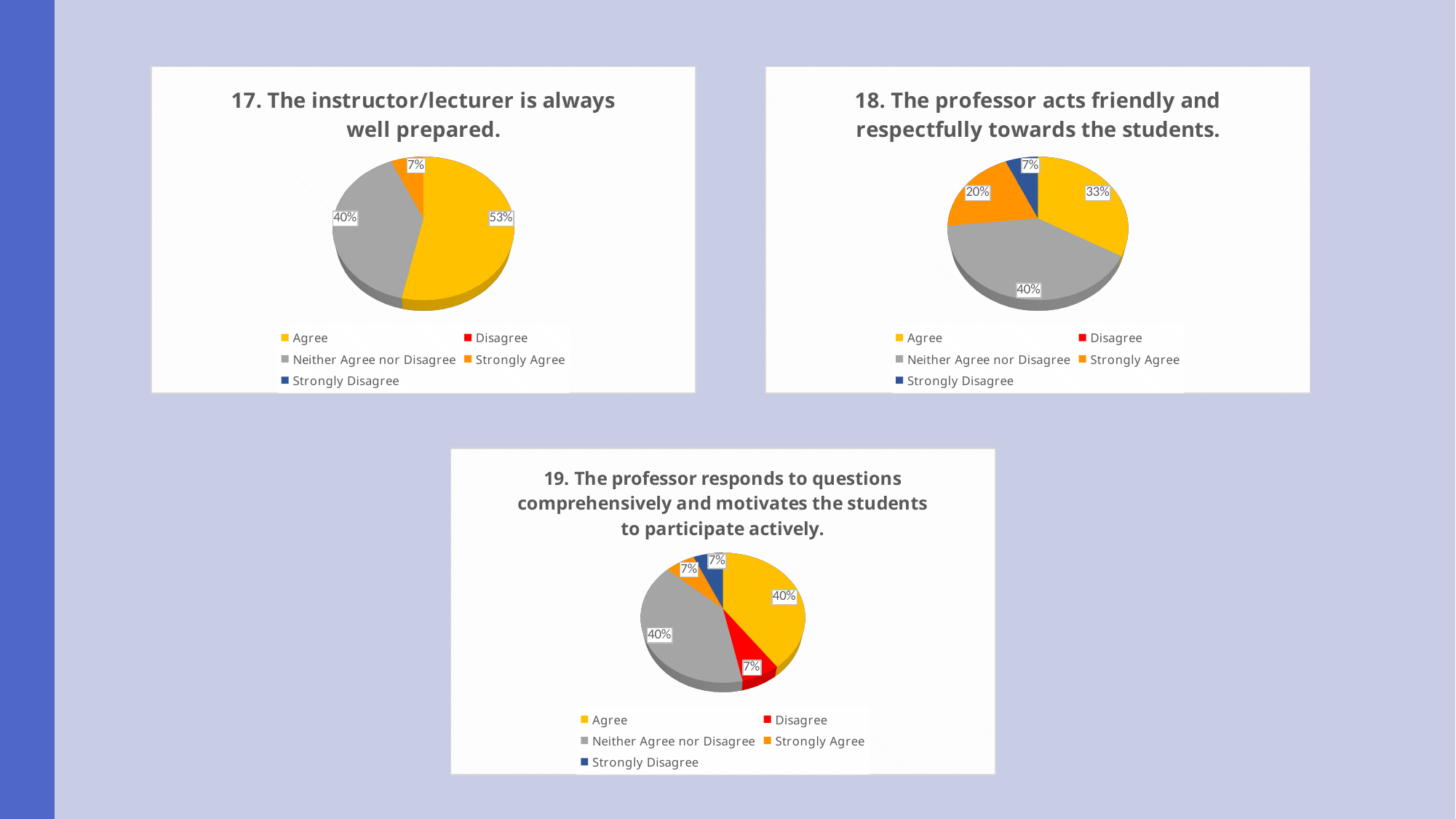
In the chart titled "18. The professor acts friendly and respectfully towards the students.", which response category has the largest slice? Neither Agree nor Disagree In the chart titled "17. The instructor/lecturer is always well prepared.", what share of responses is Strongly Agree? 7% How many entries does the legend list in the chart titled "18. The professor acts friendly and respectfully towards the students."? 5 In the chart titled "17. The instructor/lecturer is always well prepared.", what share of responses is Agree? 53% In the chart titled "19. The professor responds to questions comprehensively and motivates the students to participate actively.", how many slices does the pie have? 5 In the chart titled "18. The professor acts friendly and respectfully towards the students.", what is the difference between the Neither Agree nor Disagree share and the Agree share? 7% In the chart titled "18. The professor acts friendly and respectfully towards the students.", which is larger: Agree or Strongly Agree? Agree In the chart titled "19. The professor responds to questions comprehensively and motivates the students to participate actively.", what share of responses is Disagree? 7% What kind of chart is used for "17. The instructor/lecturer is always well prepared."? Pie chart In the chart titled "18. The professor acts friendly and respectfully towards the students.", what share of responses is Strongly Agree? 20% In the chart titled "17. The instructor/lecturer is always well prepared.", which response category has the largest slice? Agree In the chart titled "19. The professor responds to questions comprehensively and motivates the students to participate actively.", what is the combined share of Agree and Strongly Agree? 47%